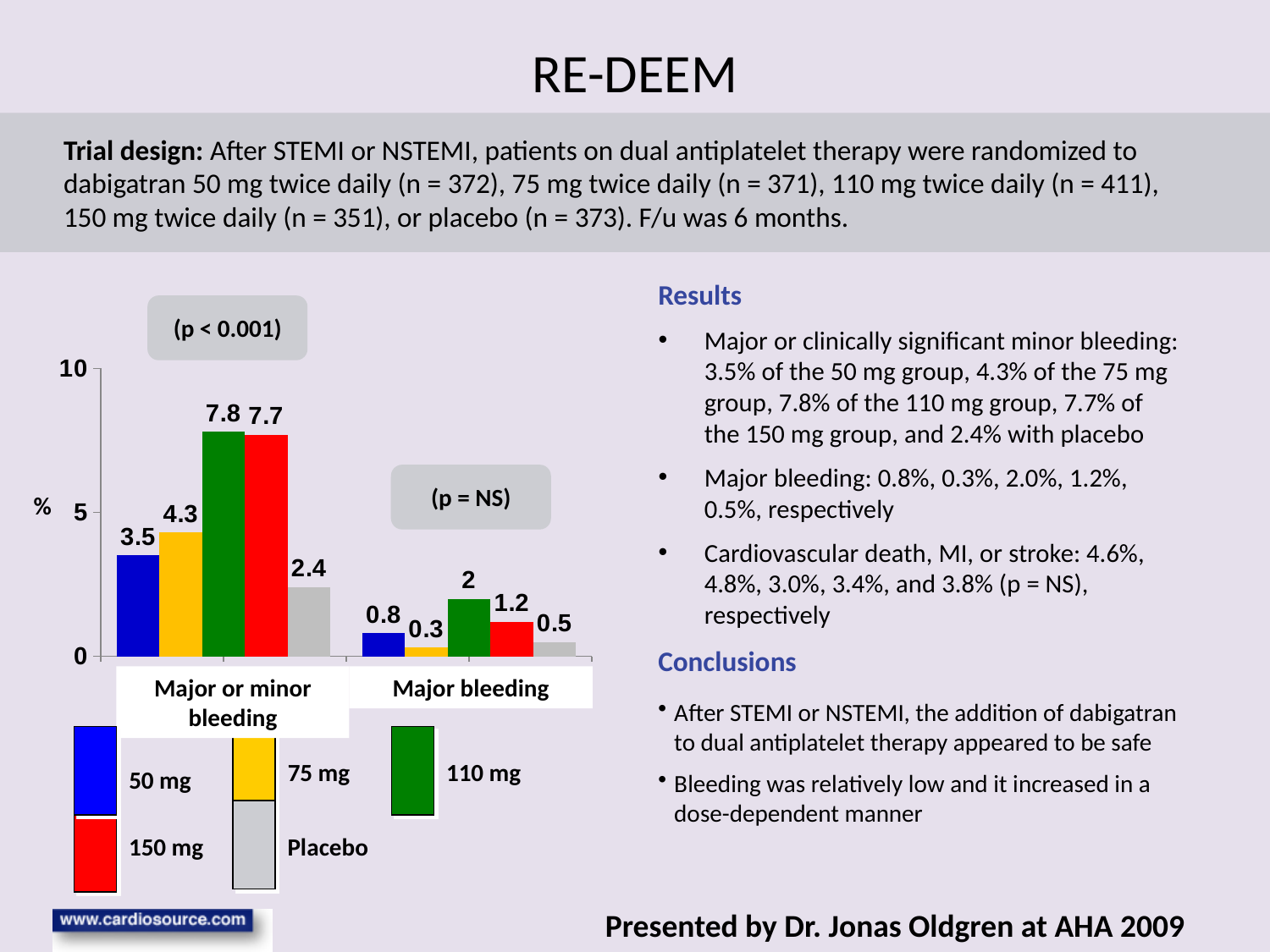
What is the value for Placebo in the Major bleeding category? 0.5 What colour represents the Placebo group in the chart? grey How many series does the legend list? 5 What is the value for the 75 mg group in the Major bleeding category? 0.3 Which group has the highest value in the Major or minor bleeding category? 110 mg Which group has the lowest value in the Major bleeding category? 75 mg What is the difference between the 110 mg and Placebo values in the Major or minor bleeding category? 5.4 Is the value for the 150 mg group in the Major or minor bleeding category greater or less than 5? greater What kind of chart is shown on the slide? bar chart How many categories are shown on the x axis of the chart? 2 What is the value for the 110 mg group in the Major or minor bleeding category? 7.8 In the Major bleeding category, which is larger: the value for 110 mg or the value for 150 mg? 110 mg